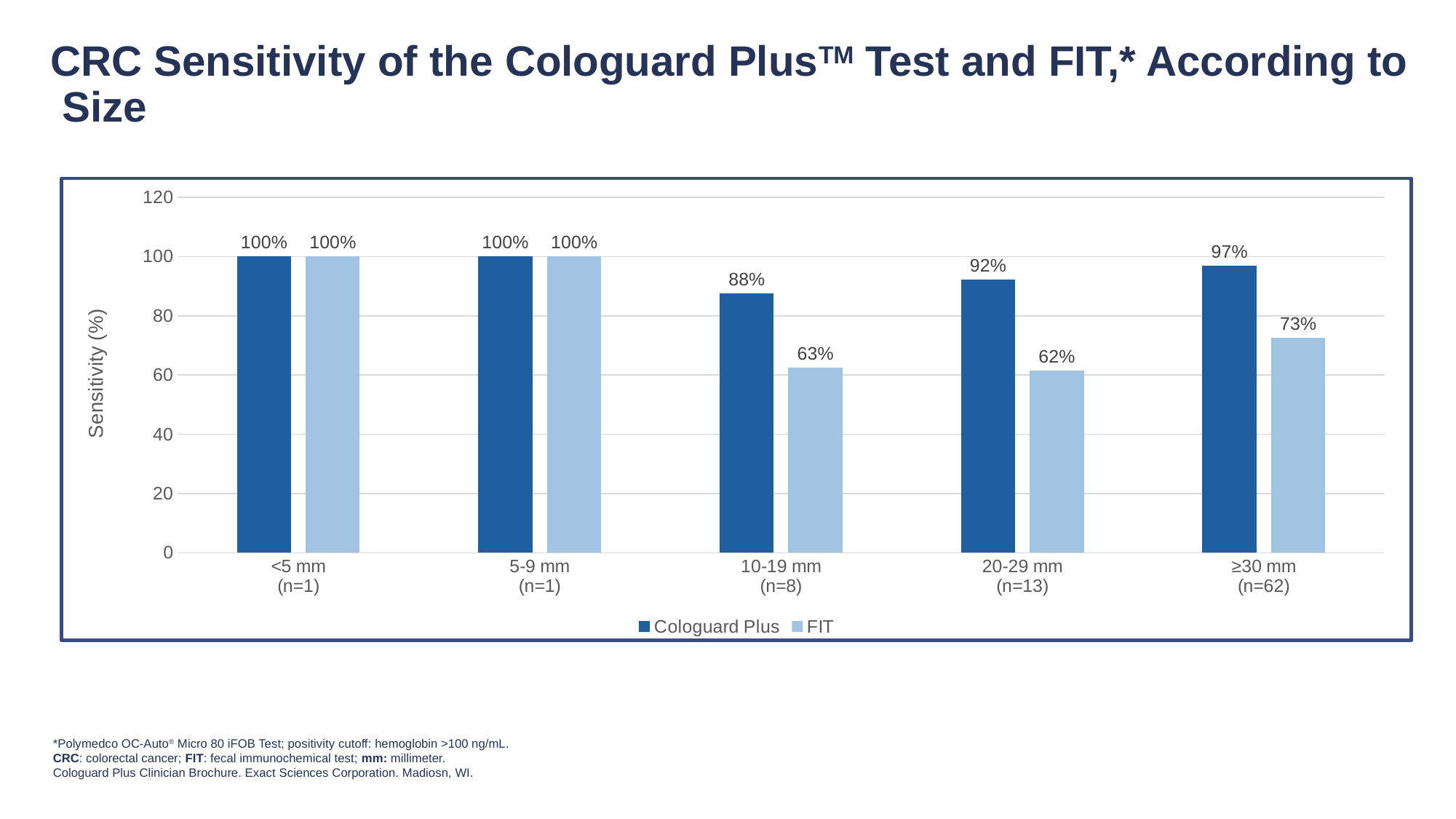
What is the Cologuard Plus sensitivity for the 10-19 mm (n=8) size category? 88% Which size category has the lowest Cologuard Plus sensitivity? 10-19 mm (n=8) For the 10-19 mm (n=8) category, which test has the higher sensitivity, Cologuard Plus or FIT? Cologuard Plus How many series does the legend list? 2 What is the difference between the Cologuard Plus and FIT sensitivity for the 20-29 mm (n=13) category? 30% What is the FIT sensitivity for the ≥30 mm (n=62) size category? 73% How many size categories are shown on the x axis? 5 What is the label of the y axis? Sensitivity (%) What is the FIT sensitivity for the 20-29 mm (n=13) size category? 62% What kind of chart is shown on the slide? Bar chart Which size category has the lowest FIT sensitivity? 20-29 mm (n=13) What is the Cologuard Plus sensitivity for the ≥30 mm (n=62) size category? 97%